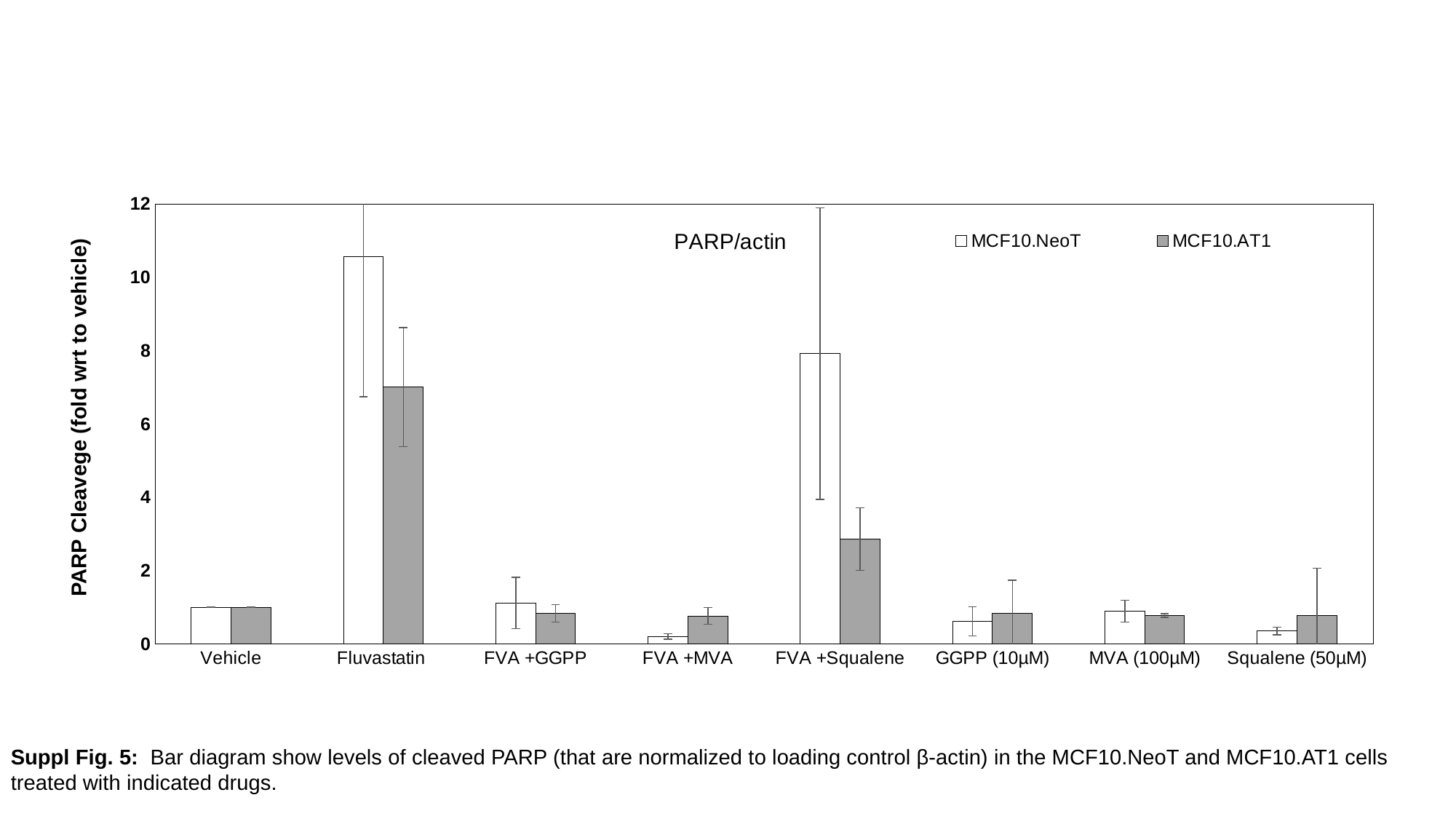
What title is printed inside the chart area? PARP/actin Is the MCF10.NeoT value for FVA +Squalene greater or less than 6? greater Which treatment has the highest PARP cleavage value for MCF10.AT1? Fluvastatin How many treatment categories are shown on the x axis? 8 How many series does the legend list? 2 Which treatment has the highest PARP cleavage value for MCF10.NeoT? Fluvastatin Which treatment has the lowest PARP cleavage value for MCF10.NeoT? FVA +MVA Is the MCF10.AT1 value for FVA +Squalene greater or less than 4? less For FVA +MVA, which series has the larger value, MCF10.NeoT or MCF10.AT1? MCF10.AT1 Is the MCF10.NeoT value for Fluvastatin greater or less than 10? greater What kind of chart is shown on the slide? bar chart For Fluvastatin, which series has the larger value, MCF10.NeoT or MCF10.AT1? MCF10.NeoT